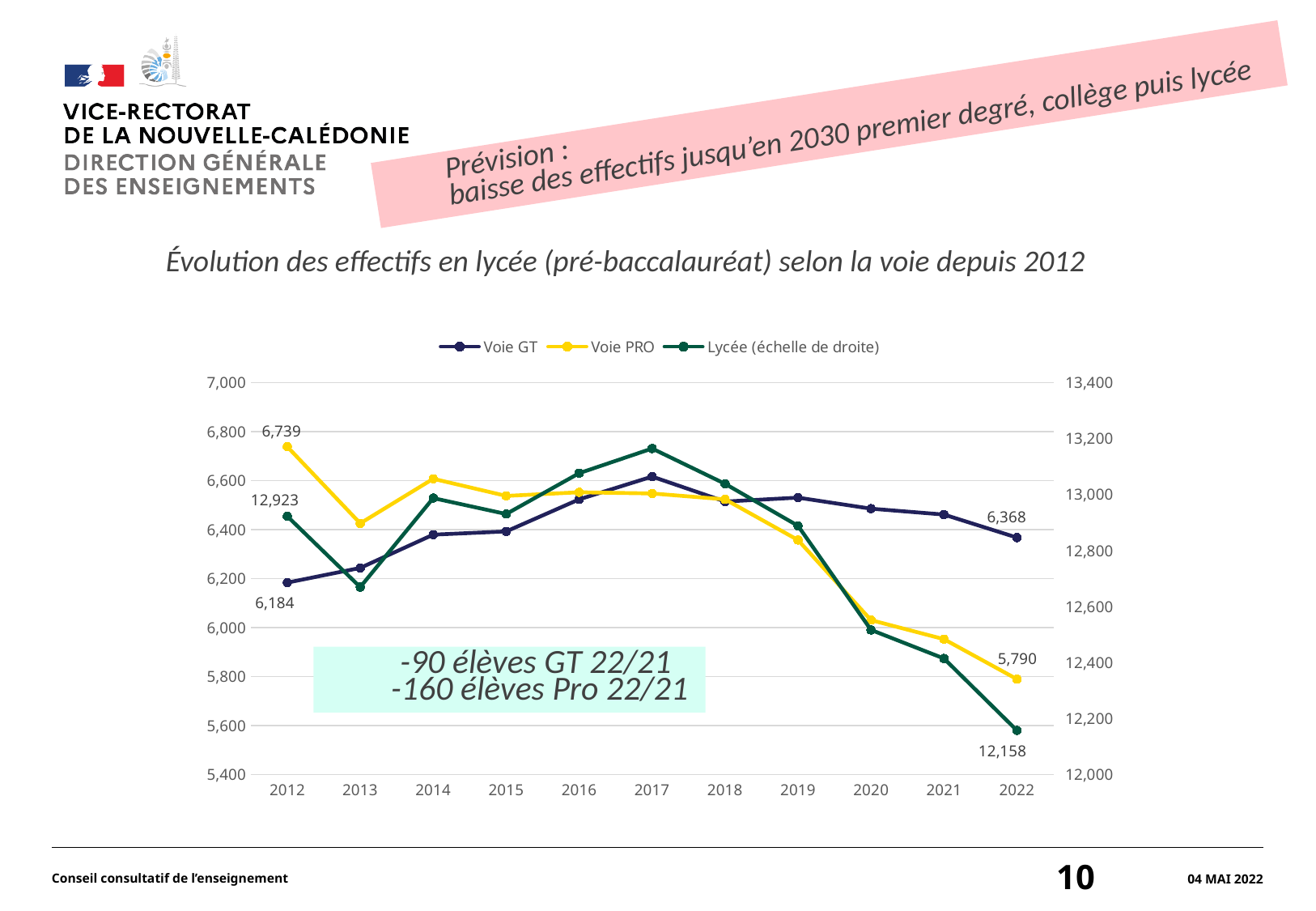
By how much did the Voie PRO value fall between 2012 and 2022? 949 What is the value for Lycée (échelle de droite) in 2012? 12,923 What is the value for Voie GT in 2022? 6,368 What is the difference between the Lycée values in 2012 and 2022? 765 How many series does the legend list? 3 What kind of chart is this? Line chart What is the value for Voie PRO in 2012? 6,739 Does the Voie PRO line rise or fall from 2017 to 2022? Fall What is the value for Lycée (échelle de droite) in 2022? 12,158 In 2022, which is larger: Voie GT or Voie PRO? Voie GT Is the value for Voie GT in 2019 greater or less than 6,400? greater How many years are shown on the x axis? 11